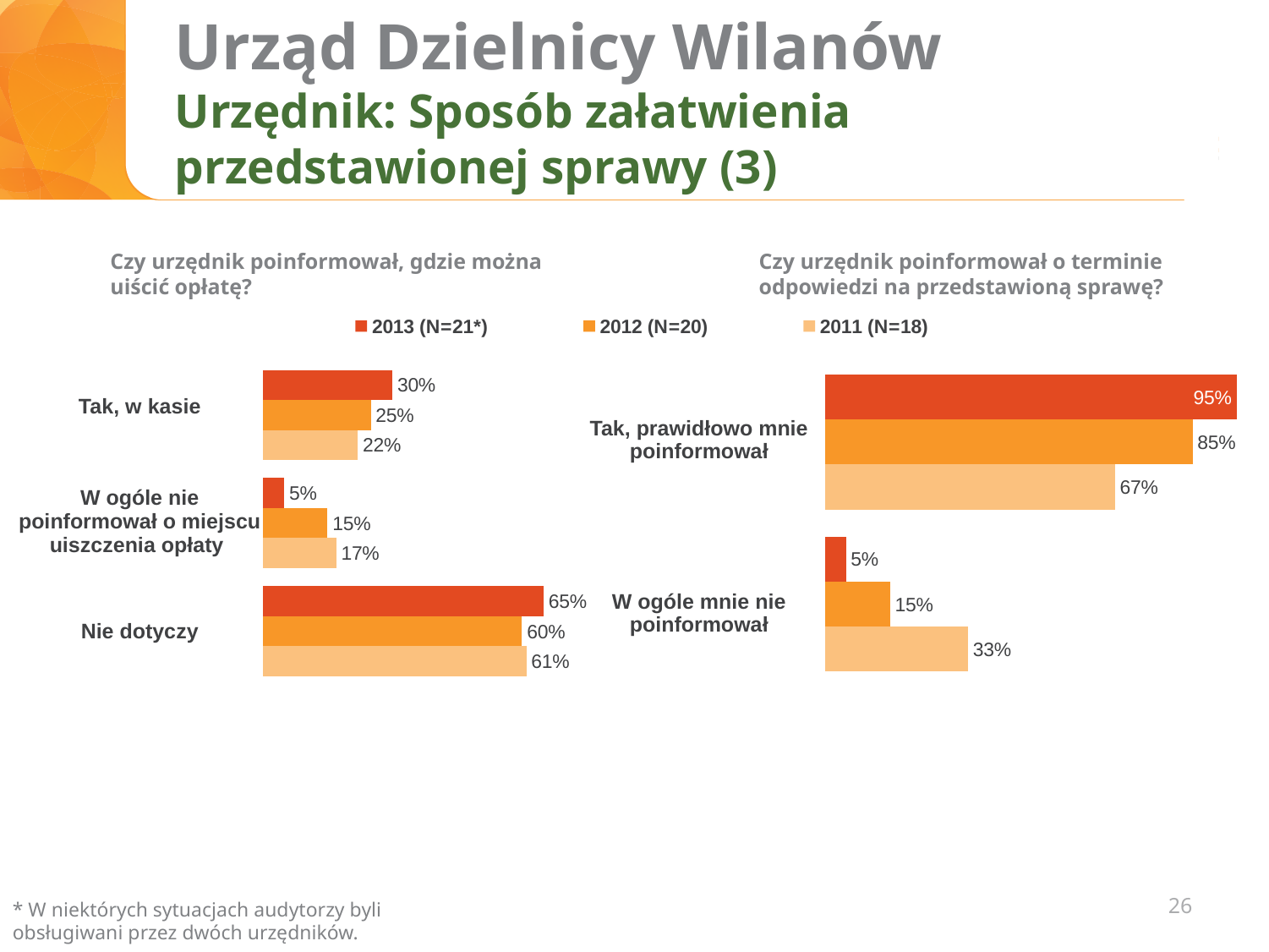
In the right chart (Czy urzędnik poinformował o terminie odpowiedzi na przedstawioną sprawę?), what is the difference between the 2013 (N=21*) and 2011 (N=18) values for 'Tak, prawidłowo mnie poinformował'? 28% In the left chart (Czy urzędnik poinformował, gdzie można uiścić opłatę?), which category has the lowest value for 2012 (N=20)? W ogóle nie poinformował o miejscu uiszczenia opłaty In the left chart (Czy urzędnik poinformował, gdzie można uiścić opłatę?), which is larger for 'W ogóle nie poinformował o miejscu uiszczenia opłaty': the 2012 (N=20) value or the 2011 (N=18) value? 2011 (N=18) In the right chart (Czy urzędnik poinformował o terminie odpowiedzi na przedstawioną sprawę?), what is the value for 'Tak, prawidłowo mnie poinformował' in 2012 (N=20)? 85% What kind of chart is the left chart (Czy urzędnik poinformował, gdzie można uiścić opłatę?)? Bar chart How many series does the legend list for the charts on this slide? 3 How many categories does the right chart (Czy urzędnik poinformował o terminie odpowiedzi na przedstawioną sprawę?) show? 2 In the right chart (Czy urzędnik poinformował o terminie odpowiedzi na przedstawioną sprawę?), what is the difference between the 2011 (N=18) and 2013 (N=21*) values for 'W ogóle mnie nie poinformował'? 28% In the left chart (Czy urzędnik poinformował, gdzie można uiścić opłatę?), which category has the highest value for 2013 (N=21*)? Nie dotyczy In the right chart (Czy urzędnik poinformował o terminie odpowiedzi na przedstawioną sprawę?), what is the value for 'W ogóle mnie nie poinformował' in 2011 (N=18)? 33% In the left chart (Czy urzędnik poinformował, gdzie można uiścić opłatę?), what is the value for 'Nie dotyczy' in 2011 (N=18)? 61% In the left chart (Czy urzędnik poinformował, gdzie można uiścić opłatę?), what is the value for 'Tak, w kasie' in 2013 (N=21*)? 30%